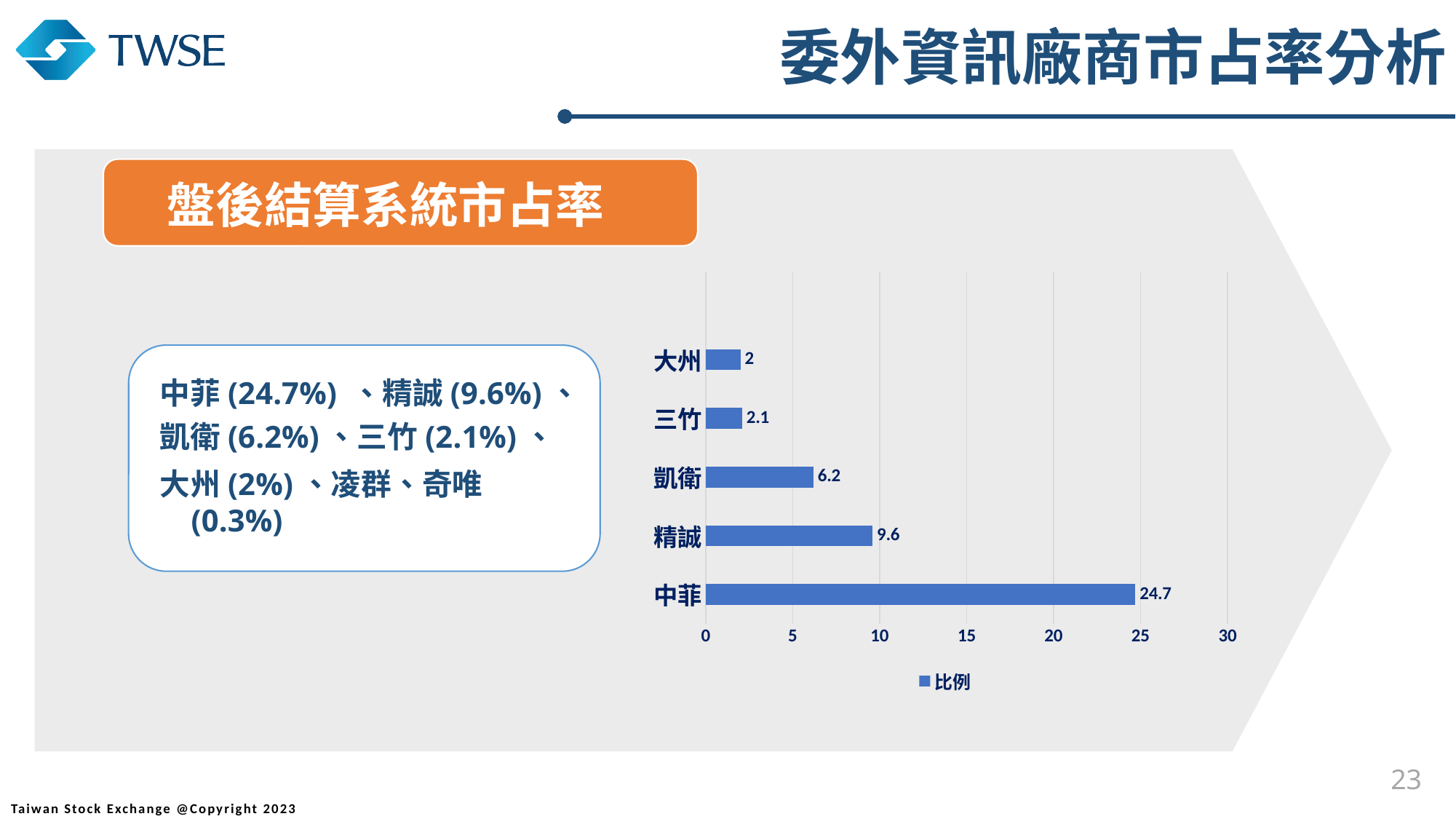
Which is larger, the value for 凱衛 or the value for 精誠? 精誠 What is the value for 中菲 in the chart? 24.7 What is the value for 三竹 in the chart? 2.1 What kind of chart is shown on the slide? bar chart Is the value for 中菲 greater or less than 20? greater What series name does the legend show? 比例 What is the difference between the values for 中菲 and 精誠? 15.1 Which category has the lowest value in the chart? 大州 What is the value for 凱衛 in the chart? 6.2 What is the value for 精誠 in the chart? 9.6 How many categories are shown in the chart? 5 Which category has the highest value in the chart? 中菲